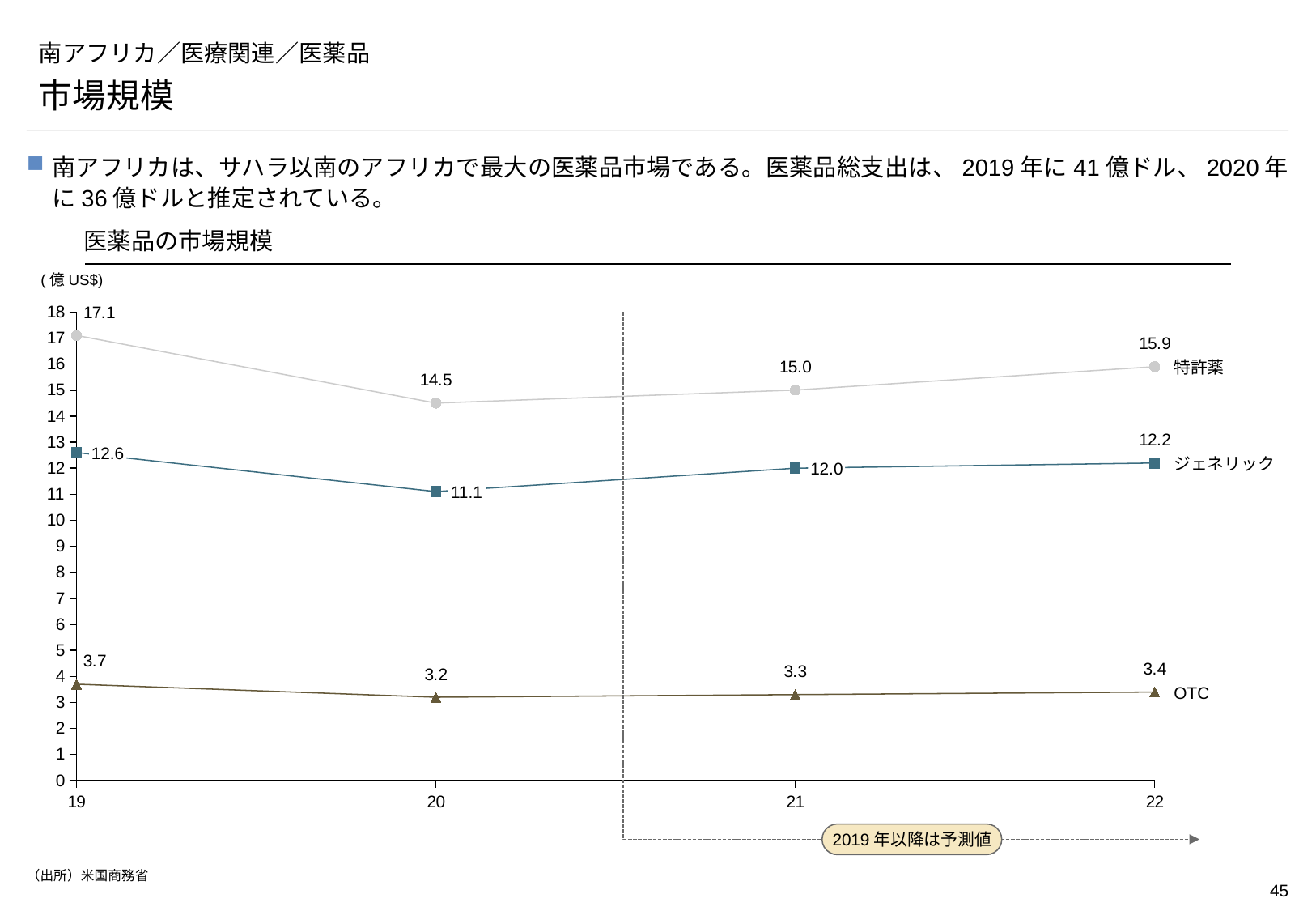
How many years are plotted on the x axis? 4 What is the value for OTC in 22? 3.4 In which year is the value for OTC lowest? 20 What is the unit shown on the chart's y axis? 億 US$ What is the value for 特許薬 in 19? 17.1 Which is larger in 22: the value for ジェネリック or the value for OTC? ジェネリック What is the value for 特許薬 in 21? 15.0 What is the value for ジェネリック in 20? 11.1 In which year is the value for 特許薬 highest? 19 How many series are shown in the chart? 3 What kind of chart is shown? line chart What is the difference between the 特許薬 value in 19 and in 20? 2.6